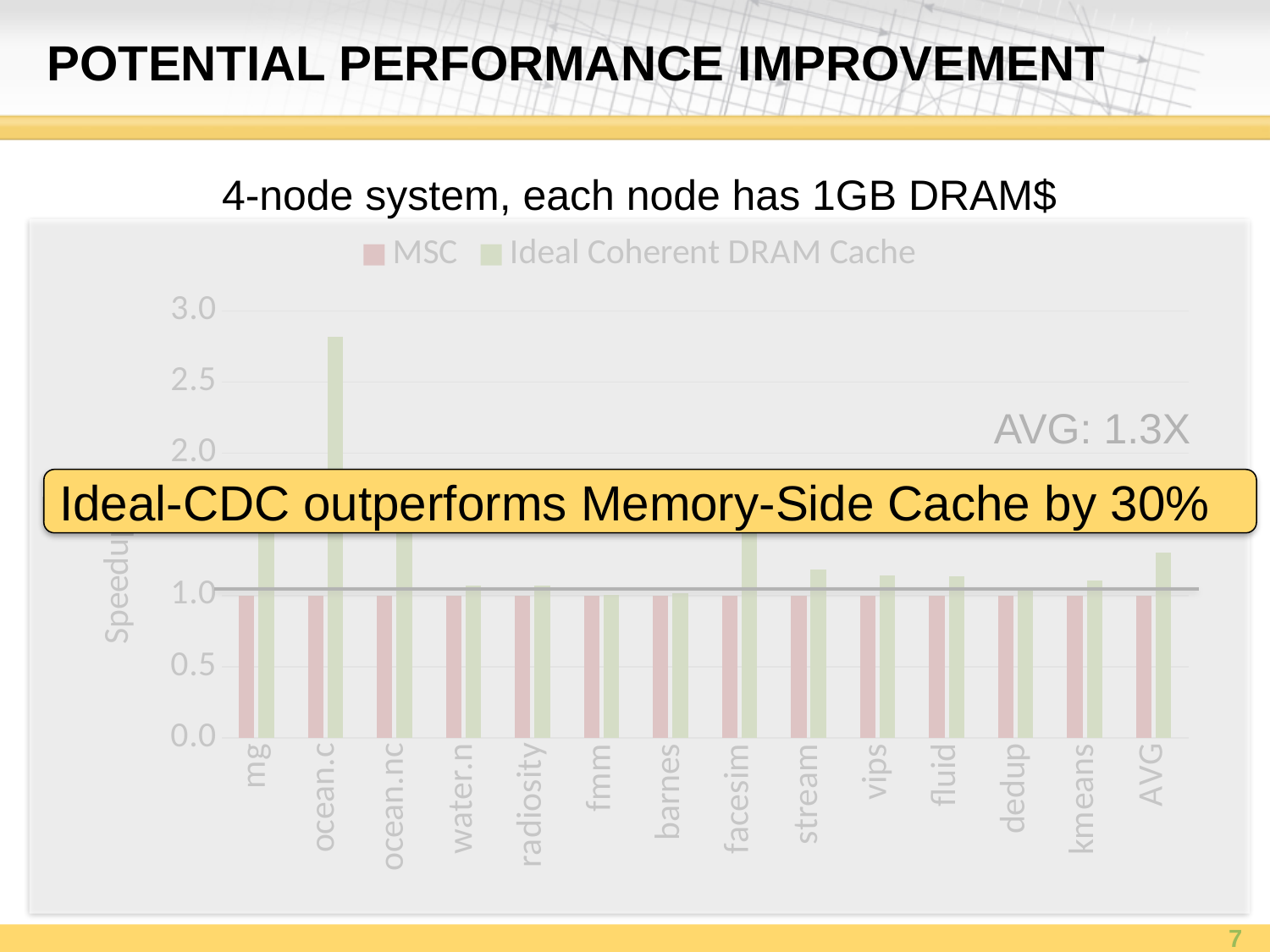
What average speedup is annotated on the chart? AVG: 1.3X Is the Ideal Coherent DRAM Cache value for stream greater or less than 1.5? less Is the Ideal Coherent DRAM Cache value for ocean.c greater or less than 2.5? greater Which is larger for ocean.c: the MSC bar or the Ideal Coherent DRAM Cache bar? Ideal Coherent DRAM Cache Which has the larger Ideal Coherent DRAM Cache value: ocean.c or stream? ocean.c Is the Ideal Coherent DRAM Cache value for AVG greater or less than 1.5? less How many series does the chart legend list? 2 What are the two series named in the chart legend? MSC and Ideal Coherent DRAM Cache How many categories are shown along the x axis of the chart? 14 Which category has the highest Ideal Coherent DRAM Cache bar? ocean.c What kind of chart is shown on the slide? bar chart